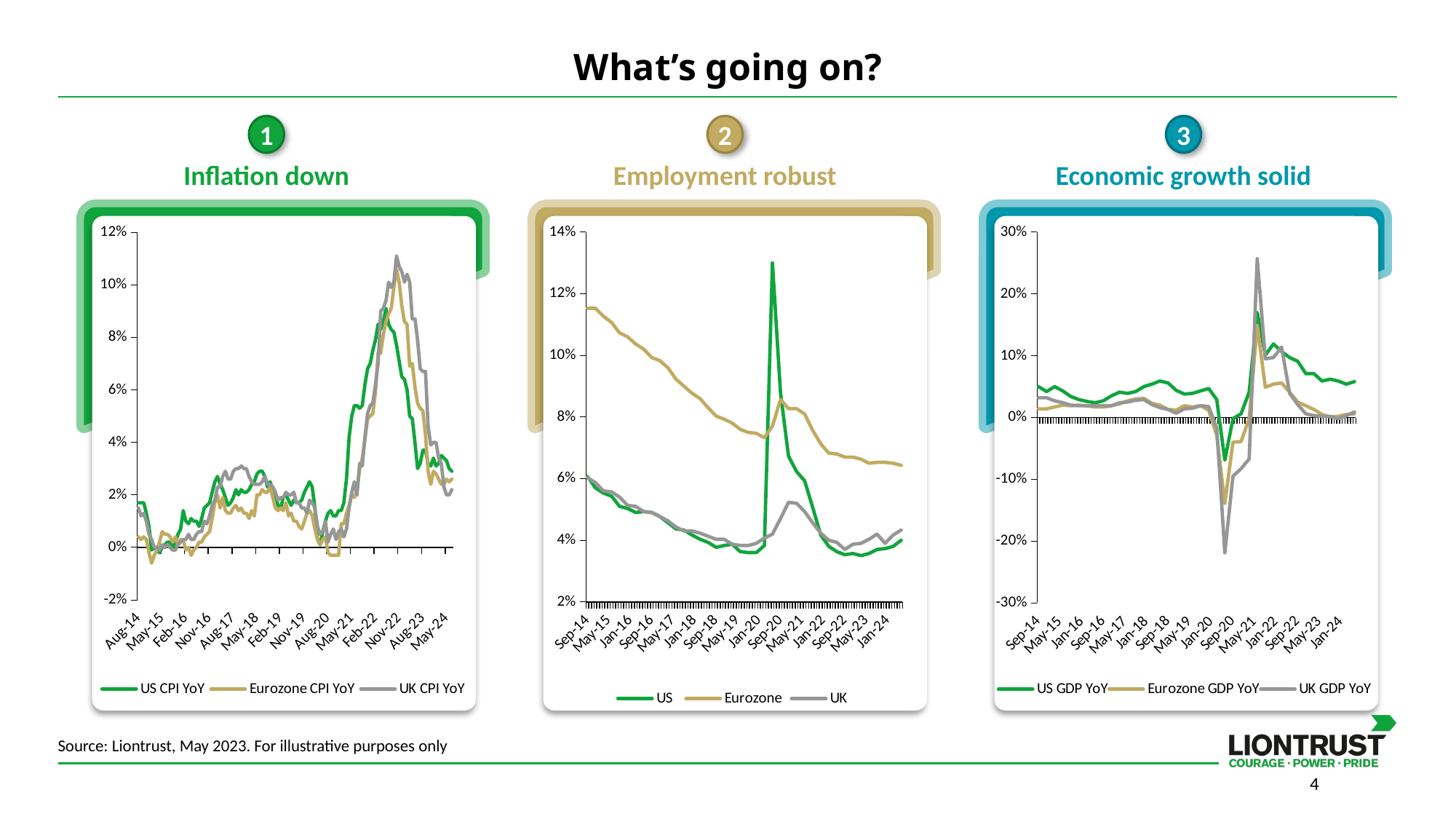
In the 'Inflation down' chart, is the peak value of US CPI YoY greater or less than 10%? less In the 'Employment robust' chart, is the peak value of the US series greater or less than 12%? greater In the 'Economic growth solid' chart, is the lowest value of UK GDP YoY greater or less than -20%? less What are the three legend entries of the 'Economic growth solid' chart? US GDP YoY, Eurozone GDP YoY, UK GDP YoY In the 'Inflation down' chart, which series reaches the highest peak? UK CPI YoY In the 'Economic growth solid' chart, which series falls to the lowest point around Sep-20? UK GDP YoY What kind of chart is the 'Inflation down' chart? Line chart How many series does the legend of the 'Employment robust' chart list? 3 How many series does the legend of the 'Inflation down' chart list? 3 In the 'Employment robust' chart, which series shows the highest spike around 2020? US In the 'Employment robust' chart, does the Eurozone series generally rise or fall from Sep-14 to Jan-24? Fall